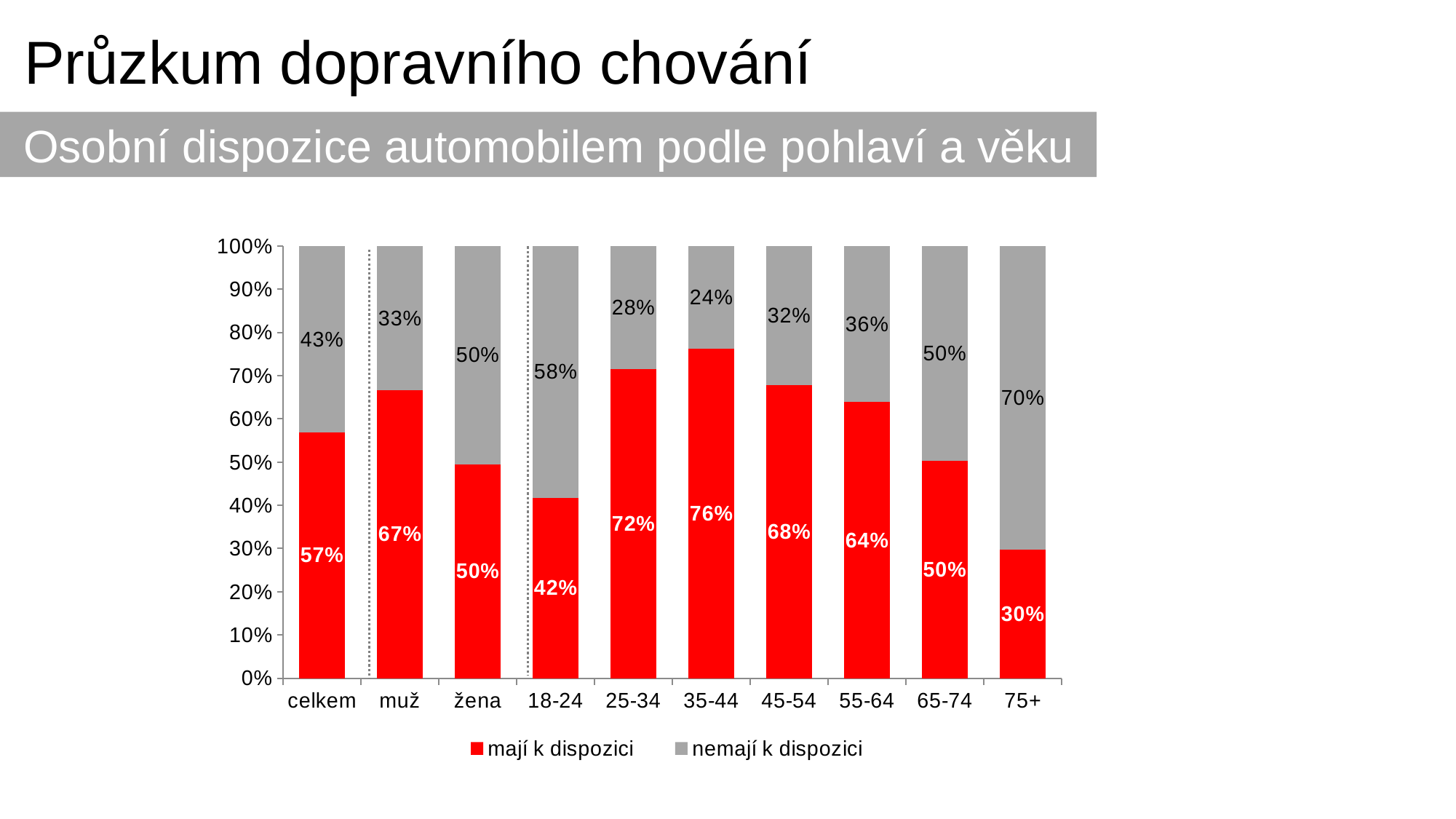
How many series does the legend list? 2 What kind of chart is shown on the slide? Stacked bar chart Which has a larger "nemají k dispozici" value, 45-54 or 55-64? 55-64 What is the value of "nemají k dispozici" for the 18-24 category? 58% What is the total of the stacked bar for the celkem category? 100% How many categories are shown on the x axis? 10 Which category has the lowest value for "mají k dispozici"? 75+ What is the value of "mají k dispozici" for muž? 67% What is the value of "mají k dispozici" for the 35-44 category? 76% Which category has the highest value for "mají k dispozici"? 35-44 Which colour represents the "nemají k dispozici" series? Grey What is the difference between the "mají k dispozici" values for muž and žena? 17%